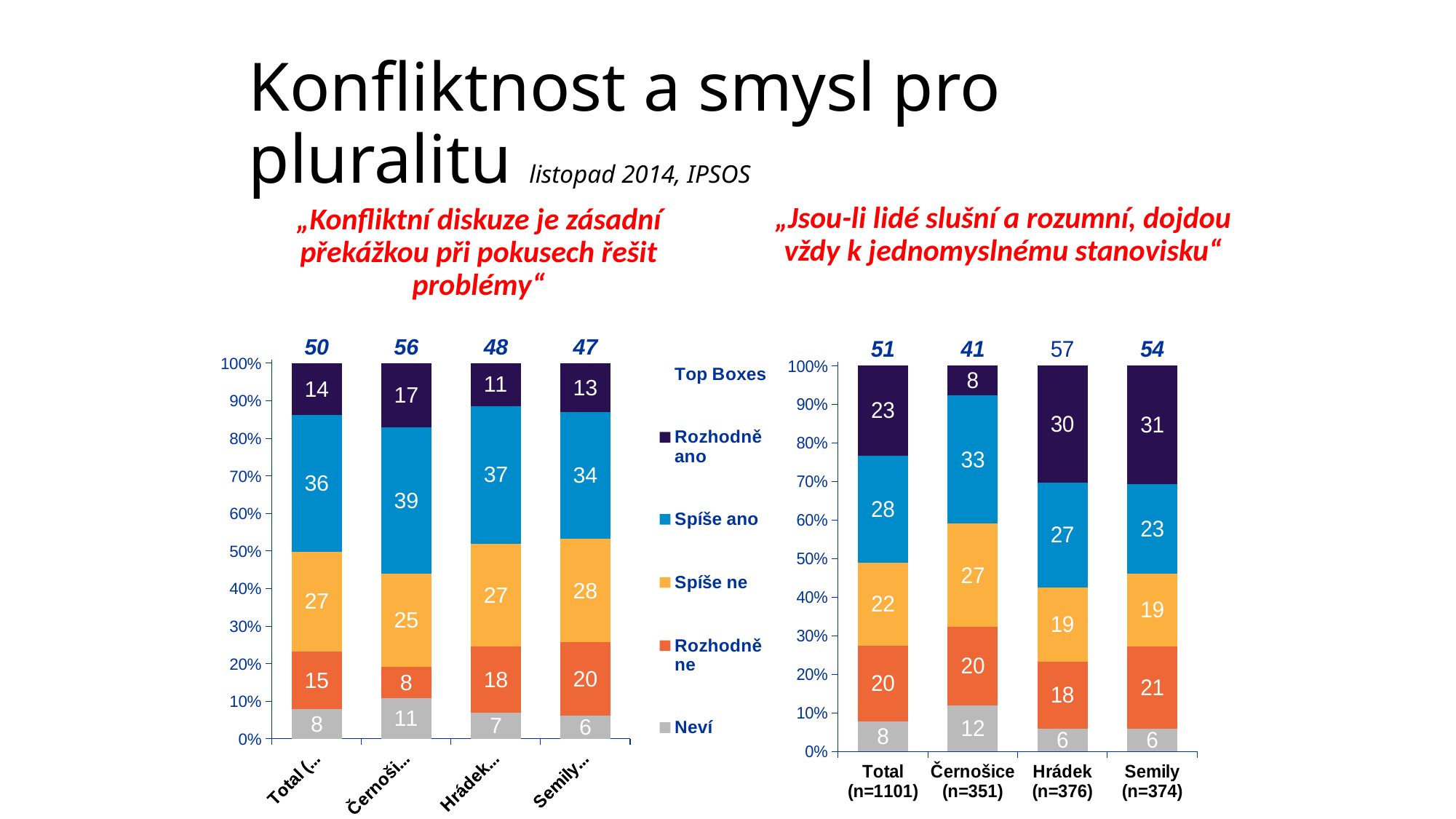
How many series does the legend list? 5 In the right chart, which category has the lowest Top Boxes value? Černošice In the left chart, what is the difference between the "Rozhodně ne" values for Semily and Černošice? 12 How many categories are shown on the x axis of the right chart? 4 In the right chart, which category has the highest "Rozhodně ano" value? Semily In the right chart, which is larger: the "Spíše ne" value for Černošice or for Total? Černošice In the left chart ("Konfliktní diskuze je zásadní překážkou..."), what is the "Spíše ano" value for Černošice? 39 In the left chart, what is the "Neví" value for Semily? 6 In the right chart ("Jsou-li lidé slušní a rozumní..."), what is the "Rozhodně ano" value for Hrádek? 30 In the right chart, what is the difference between the Top Boxes values for Hrádek and Černošice? 16 In the left chart, what is the Top Boxes value shown above the Černošice bar? 56 What kind of chart is the left chart? Stacked bar chart